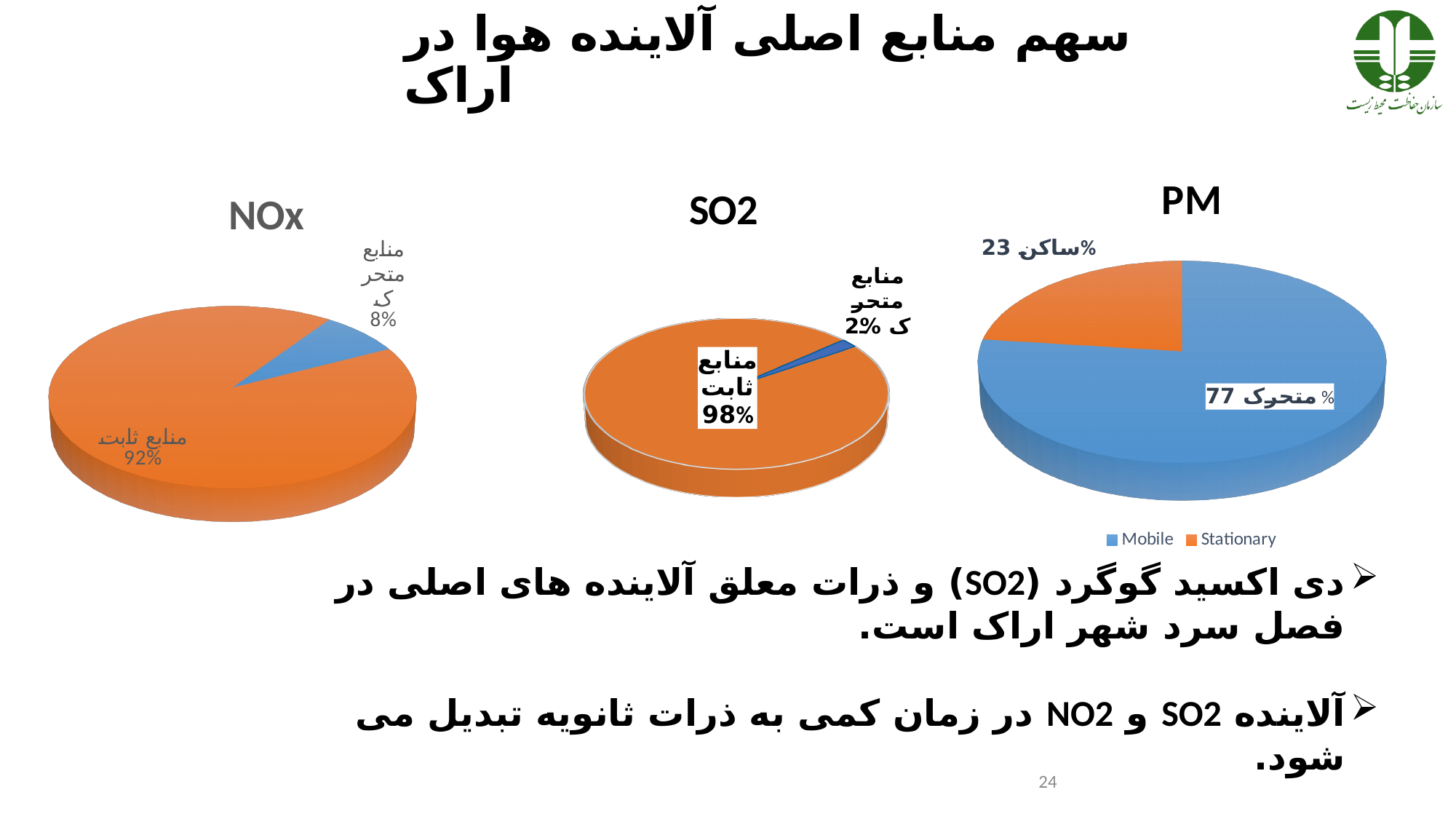
What entries does the legend under the PM chart list? Mobile, Stationary How many slices does the PM chart have? 2 What type of chart is used for NOx, SO2 and PM on this slide? Pie chart In the PM chart, what share is labelled for stationary sources (ساکن)? 23% In the NOx chart, what is the difference between the stationary and mobile source shares? 84 percentage points In the PM chart, what share is labelled for mobile sources (متحرک)? 77% In the SO2 chart, what share is labelled for mobile sources (منابع متحرک)? 2% In the SO2 chart, which source has the smallest share? منابع متحرک (mobile sources) In the SO2 chart, what share is labelled for stationary sources (منابع ثابت)? 98% In the NOx chart, what share is labelled for mobile sources (منابع متحرک)? 8% In the PM chart, which slice is larger, mobile or stationary? Mobile In the NOx chart, what share is labelled for stationary sources (منابع ثابت)? 92%